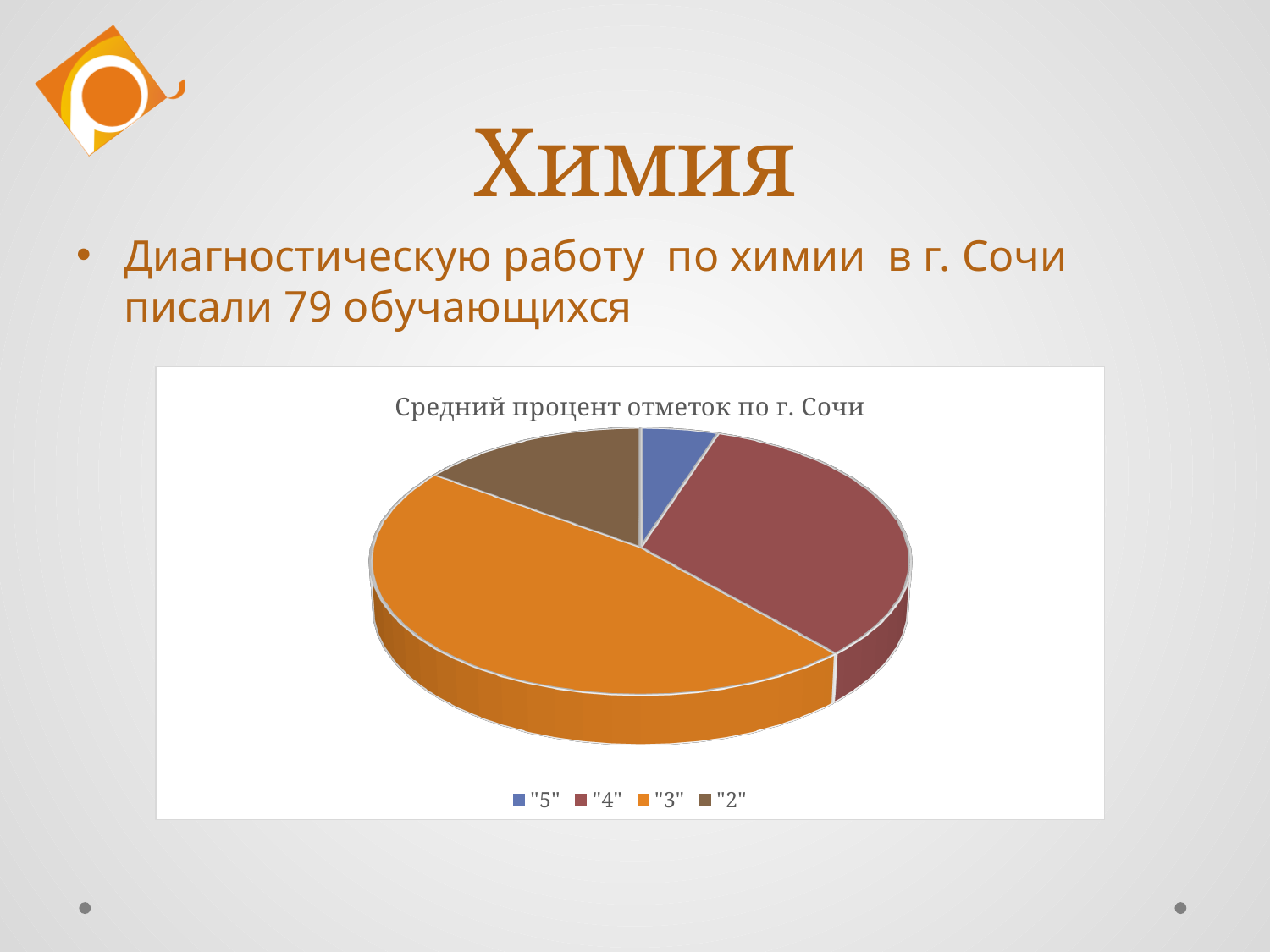
What kind of chart is shown on the slide? pie chart What colour is the slice for grade "3"? orange Which slice is larger, "3" or "4"? "3" How many slices does the pie chart have? 4 How many entries does the chart legend list? 4 Which slice is larger, "2" or "5"? "2" Which slice is larger, "4" or "2"? "4" Which grade has the smallest slice of the pie? "5" What is the title of the chart? Средний процент отметок по г. Сочи Which grade has the largest slice of the pie? "3"